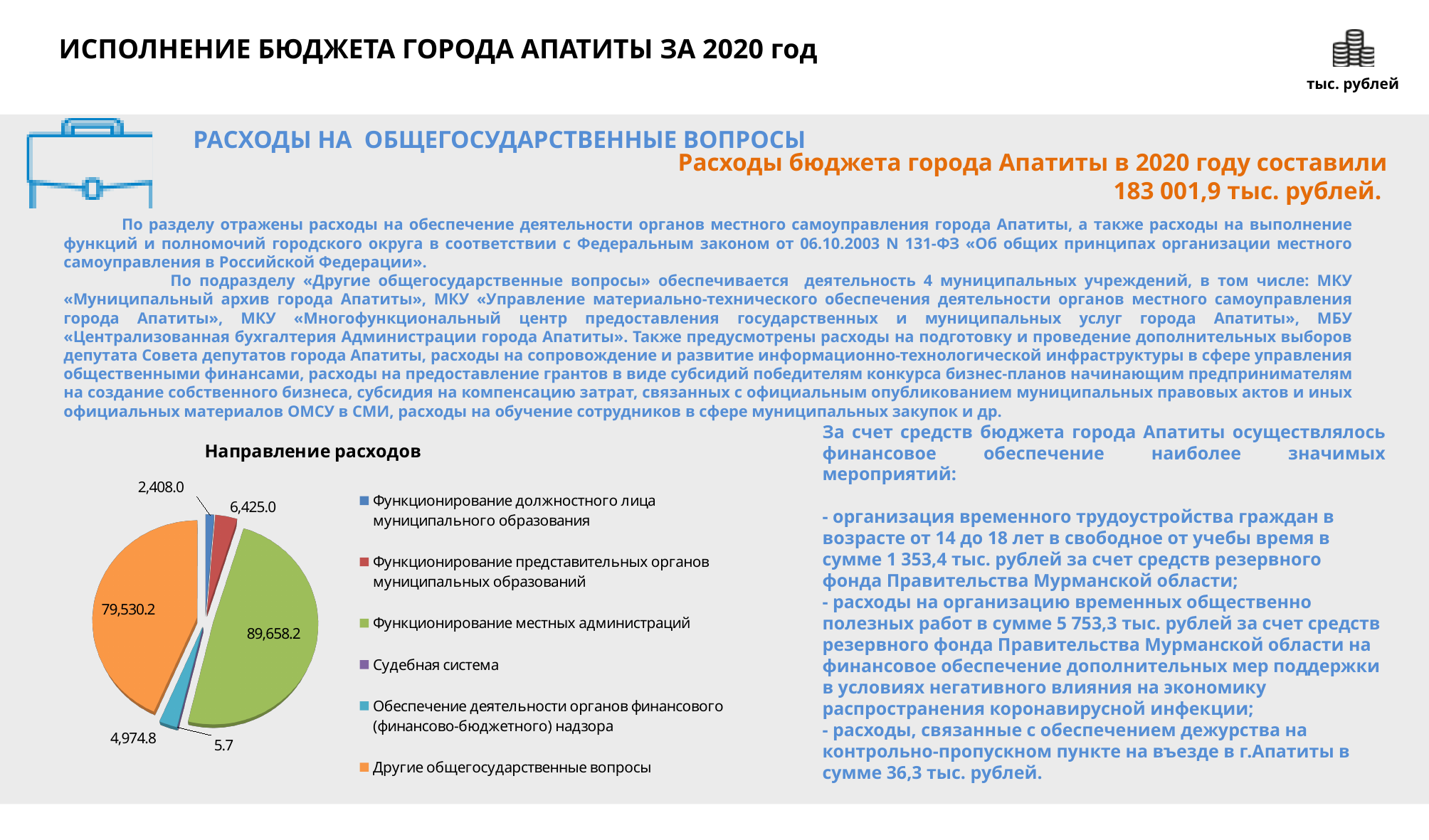
In the pie chart "Направление расходов", what is the value for "Функционирование местных администраций"? 89,658.2 In the pie chart "Направление расходов", what is the value for "Обеспечение деятельности органов финансового (финансово-бюджетного) надзора"? 4,974.8 In the pie chart "Направление расходов", what colour is the slice for "Другие общегосударственные вопросы"? Orange In the pie chart "Направление расходов", what is the value for "Другие общегосударственные вопросы"? 79,530.2 In the pie chart "Направление расходов", which category has the smallest value? Судебная система In the pie chart "Направление расходов", which category has the largest value? Функционирование местных администраций In the pie chart "Направление расходов", what is the difference between the values for "Функционирование местных администраций" and "Другие общегосударственные вопросы"? 10,128.0 In the pie chart "Направление расходов", which is larger: "Функционирование представительных органов муниципальных образований" or "Функционирование должностного лица муниципального образования"? Функционирование представительных органов муниципальных образований In the pie chart "Направление расходов", what is the value for "Функционирование представительных органов муниципальных образований"? 6,425.0 How many categories does the pie chart "Направление расходов" show? 6 What kind of chart is shown under the title "Направление расходов"? Pie chart In the pie chart "Направление расходов", what is the value for "Судебная система"? 5.7